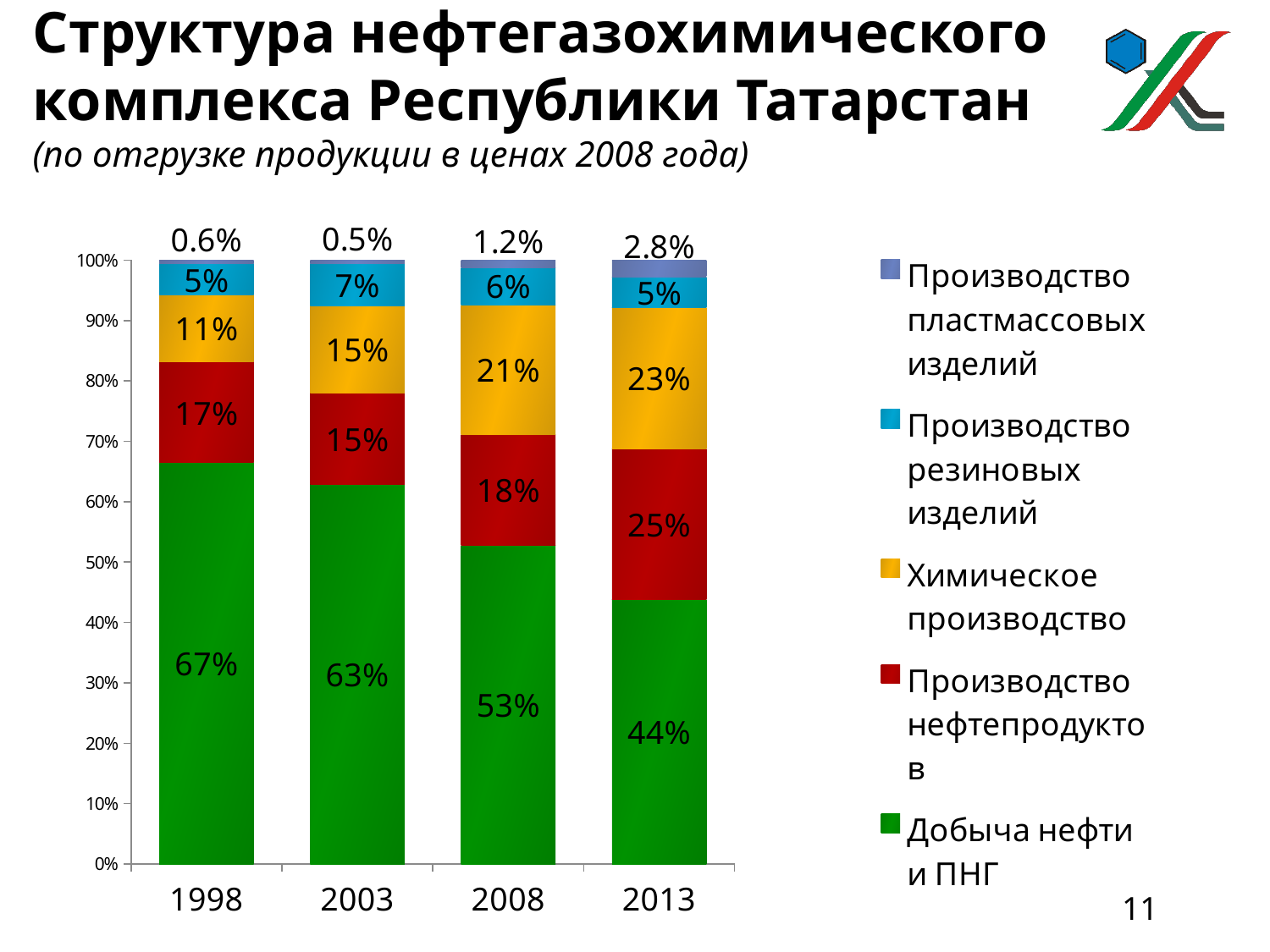
What is the difference between the share of Добыча нефти и ПНГ in 1998 and in 2013? 23% What is the share of Добыча нефти и ПНГ in 2013? 44% Which is larger in 2013: the share of Химическое производство or the share of Производство нефтепродуктов? Производство нефтепродуктов What is the share of Производство пластмассовых изделий in 1998? 0.6% How many years are shown on the x axis? 4 What is the share of Химическое производство in 2008? 21% What kind of chart is shown on the slide? stacked bar chart What is the share of Производство нефтепродуктов in 2003? 15% In which year is the share of Добыча нефти и ПНГ highest? 1998 How many series does the legend list? 5 Does the share of Добыча нефти и ПНГ rise or fall from 1998 to 2013? fall In which year is the share of Производство пластмассовых изделий lowest? 2003